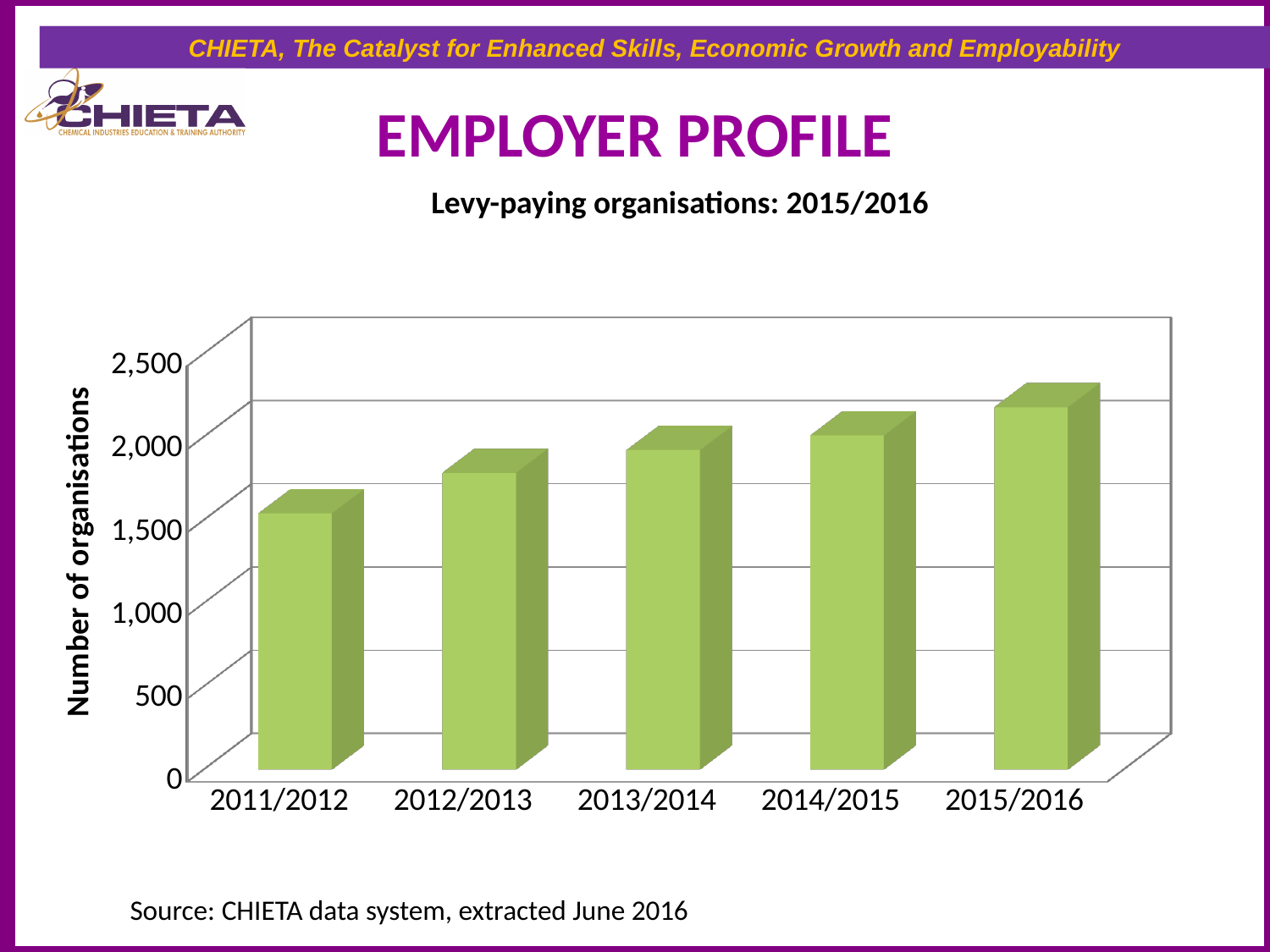
Is the value for 2015/2016 greater or less than 2,500? less Which is larger, the value for 2012/2013 or the value for 2014/2015? 2014/2015 Which is larger, the value for 2011/2012 or the value for 2015/2016? 2015/2016 Is the value for 2011/2012 greater or less than 2,000? less Which year has the highest number of levy-paying organisations? 2015/2016 What is the title of the chart? Levy-paying organisations: 2015/2016 What is the label on the vertical axis? Number of organisations Which year has the lowest number of levy-paying organisations? 2011/2012 Do the values rise or fall from 2011/2012 to 2015/2016? Rise Is the value for 2012/2013 greater or less than 1,500? greater How many financial years are plotted on the chart? 5 What kind of chart is shown on the slide? Bar chart